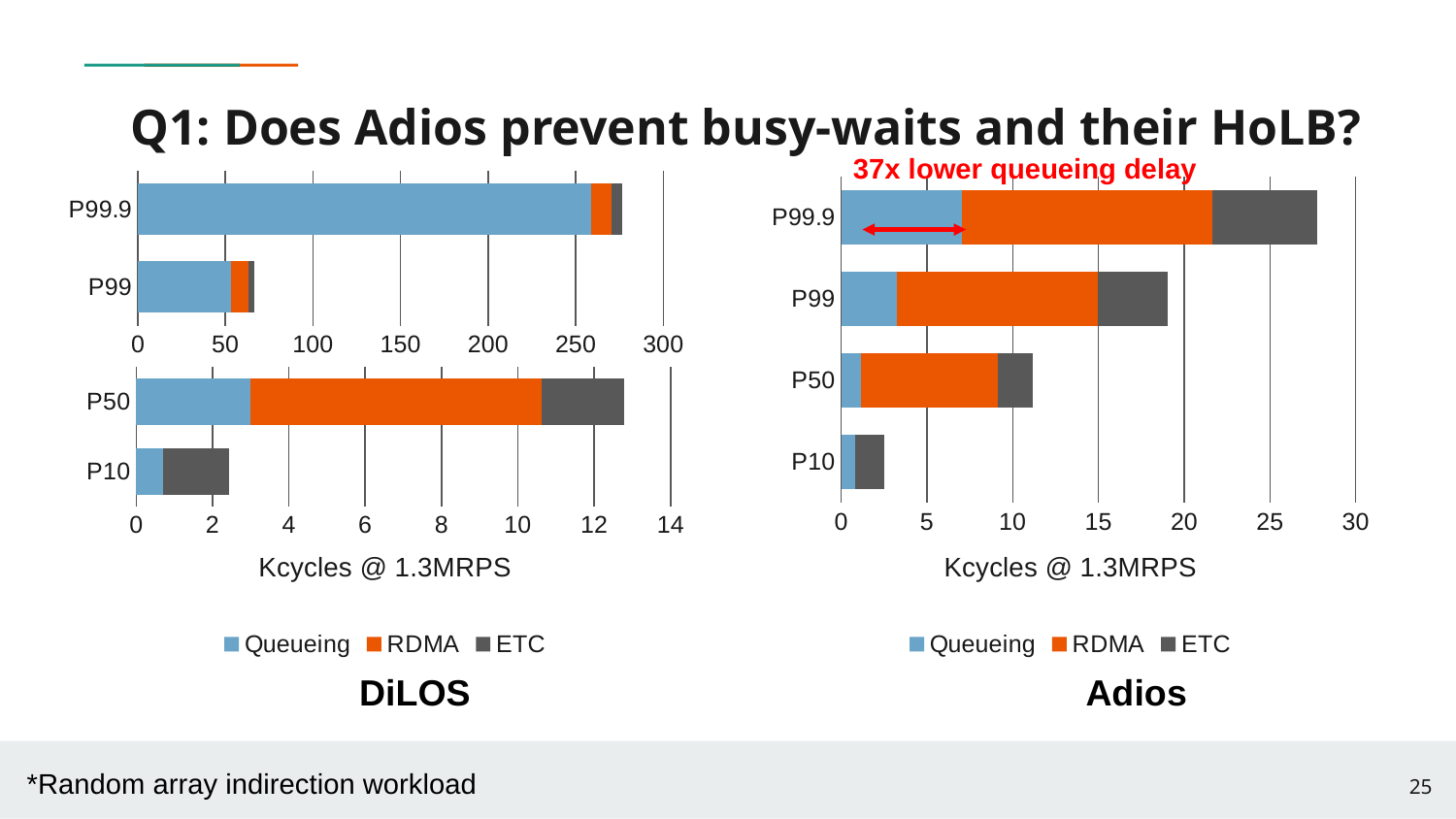
In the DiLOS chart, is the total value for P10 greater or less than 4? less How many series does the legend of the Adios chart list? 3 What kind of chart is the DiLOS chart on the left? Stacked bar chart In the Adios chart, is the total value for P99.9 greater or less than 25? greater In the Adios chart, which has the larger total bar, P99 or P50? P99 In the Adios chart, is the total value for P99 greater or less than 20? less In the Adios chart, which percentile has the shortest total bar? P10 What is the x-axis label of the Adios chart? Kcycles @ 1.3MRPS In the Adios chart, which percentile has the longest total bar? P99.9 How many percentile categories are plotted in the Adios chart? 4